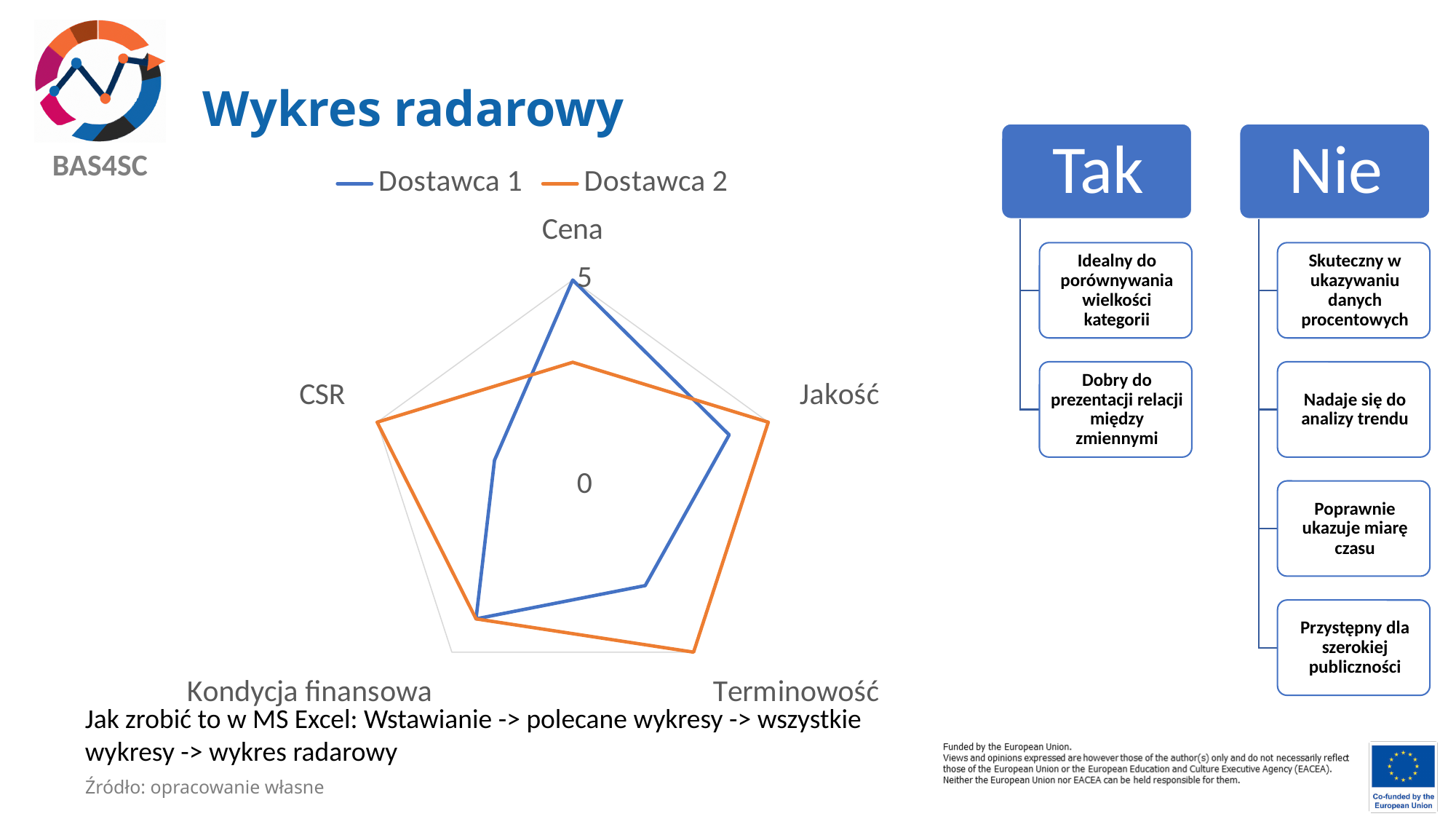
What kind of chart is shown on the slide? radar chart On which axis does Dostawca 2 have its lowest value? Cena Which series has the higher value on the CSR axis, Dostawca 1 or Dostawca 2? Dostawca 2 Which series has the higher value on the Cena axis, Dostawca 1 or Dostawca 2? Dostawca 1 Is the value for Dostawca 2 on the Cena axis greater or less than 5? less On which axis does Dostawca 1 reach its highest value? Cena How many series does the legend of the radar chart list? 2 What are the two series named in the legend of the radar chart? Dostawca 1 and Dostawca 2 What is the value for Dostawca 2 on the CSR axis? 5 What is the value for Dostawca 1 on the Cena axis? 5 How many categories (axes) does the radar chart have? 5 What is the value for Dostawca 2 on the Jakość axis? 5